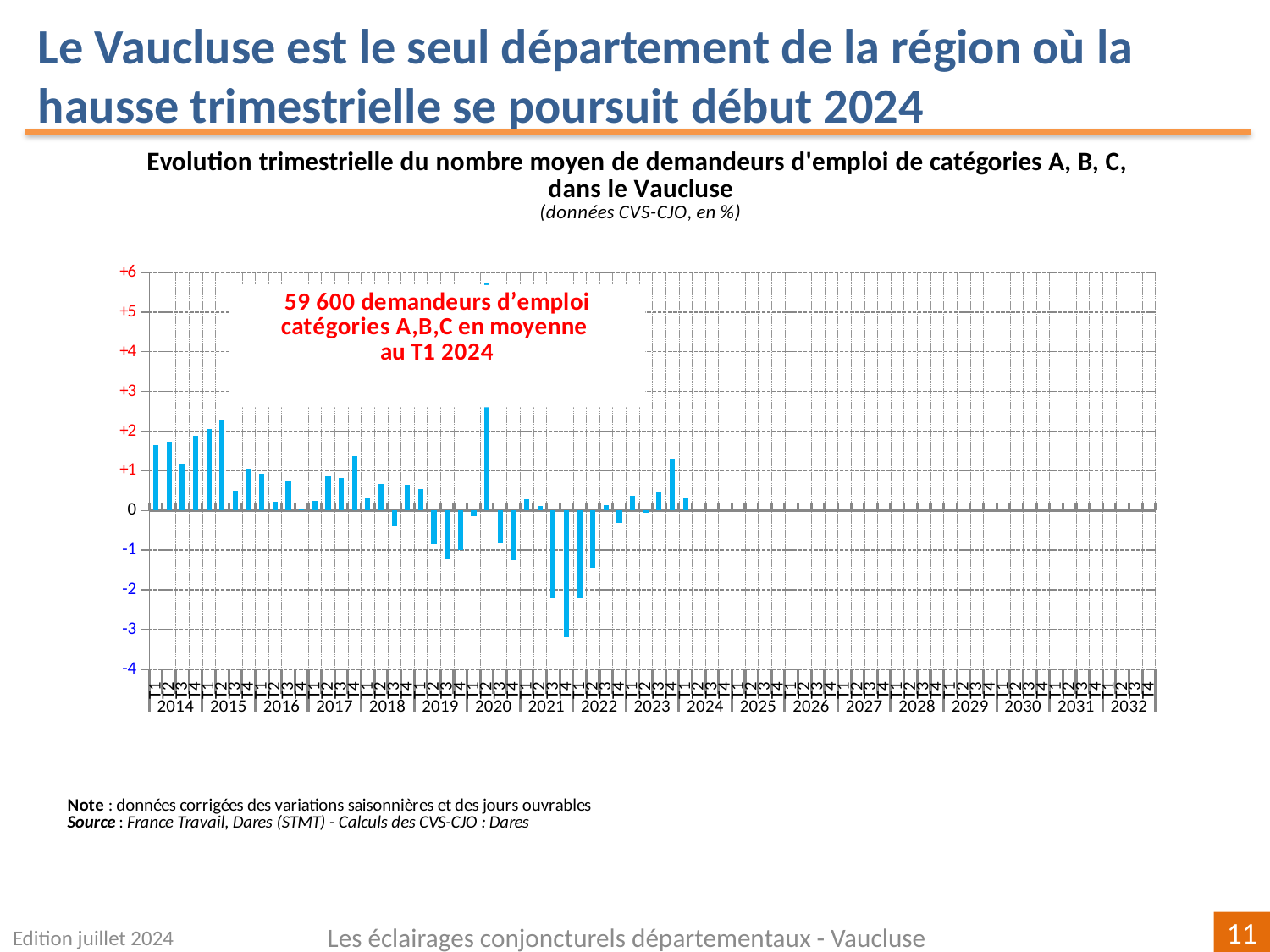
Which quarter shows the lowest value on the chart? T4 2021 What kind of chart is used to show the quarterly evolution of job seekers in the Vaucluse? bar chart Is the value for T1 2024 greater or less than 0? greater Is the value for T4 2023 greater or less than +1? greater What is the source of the data shown in the chart? France Travail, Dares (STMT) - Calculs des CVS-CJO : Dares Is the value for T2 2020 greater or less than +2? greater According to the annotation on the chart, how many job seekers in categories A, B, C were there on average in T1 2024? 59 600 Which quarter shows the highest value on the chart? T2 2020 Which is larger, the value for T4 2023 or the value for T1 2024? T4 2023 Which is larger, the value for T3 2021 or the value for T4 2021? T3 2021